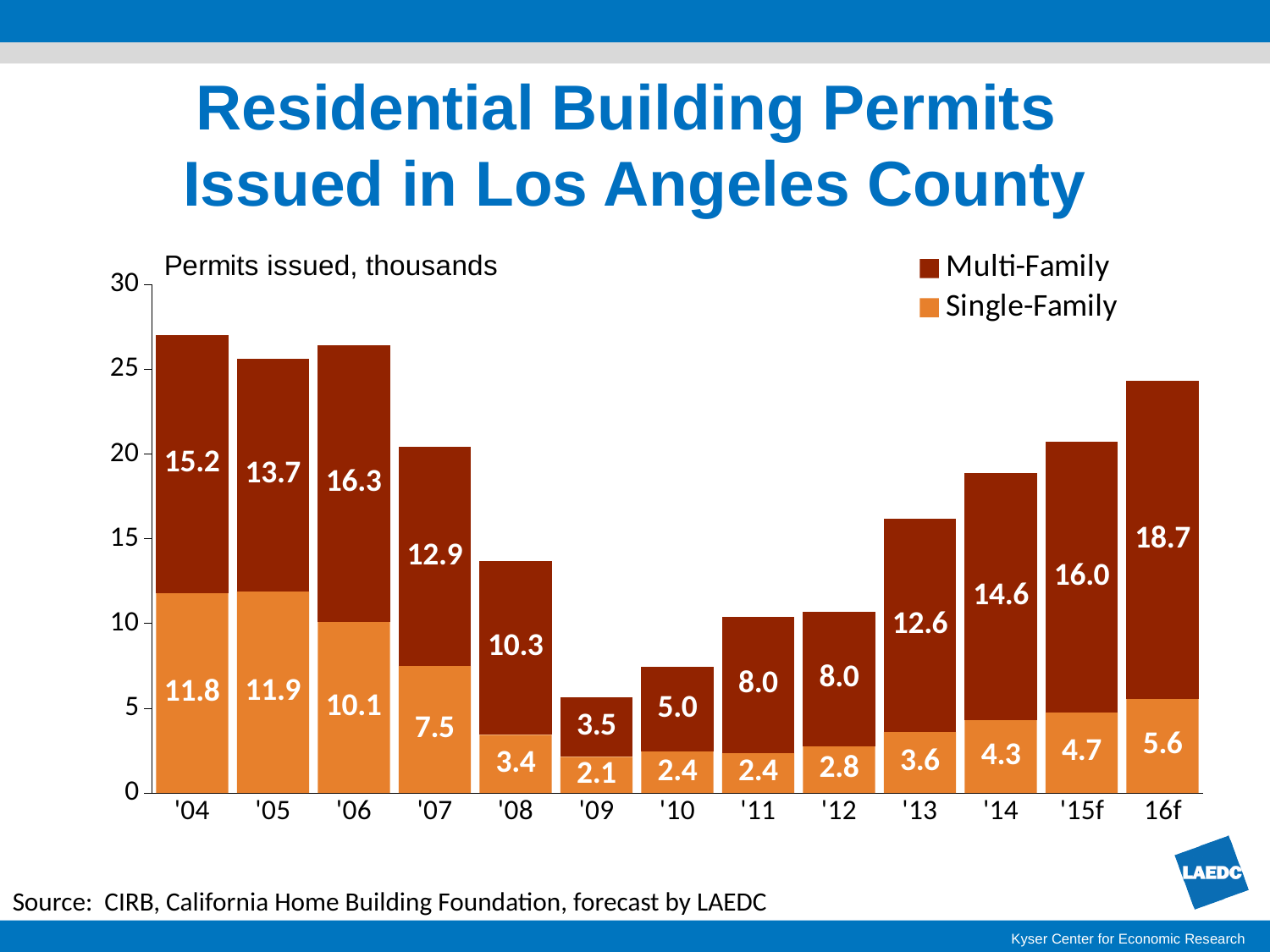
How many years are shown along the x axis? 13 Do the Multi-Family values rise or fall from '09 to 16f? rise What is the Single-Family value for '14? 4.3 What is the difference between the Multi-Family values for '06 and '05? 2.6 What is the total of the stacked bar for '09? 5.6 What unit does the axis label say the permits are measured in? thousands Which year has the highest Multi-Family value? 16f Which is larger, the Single-Family value for '08 or for '13? '13 Which year has the lowest Single-Family value? '09 What type of chart is shown on the slide? stacked bar chart What is the Multi-Family value for '07? 12.9 How many series does the legend list? 2